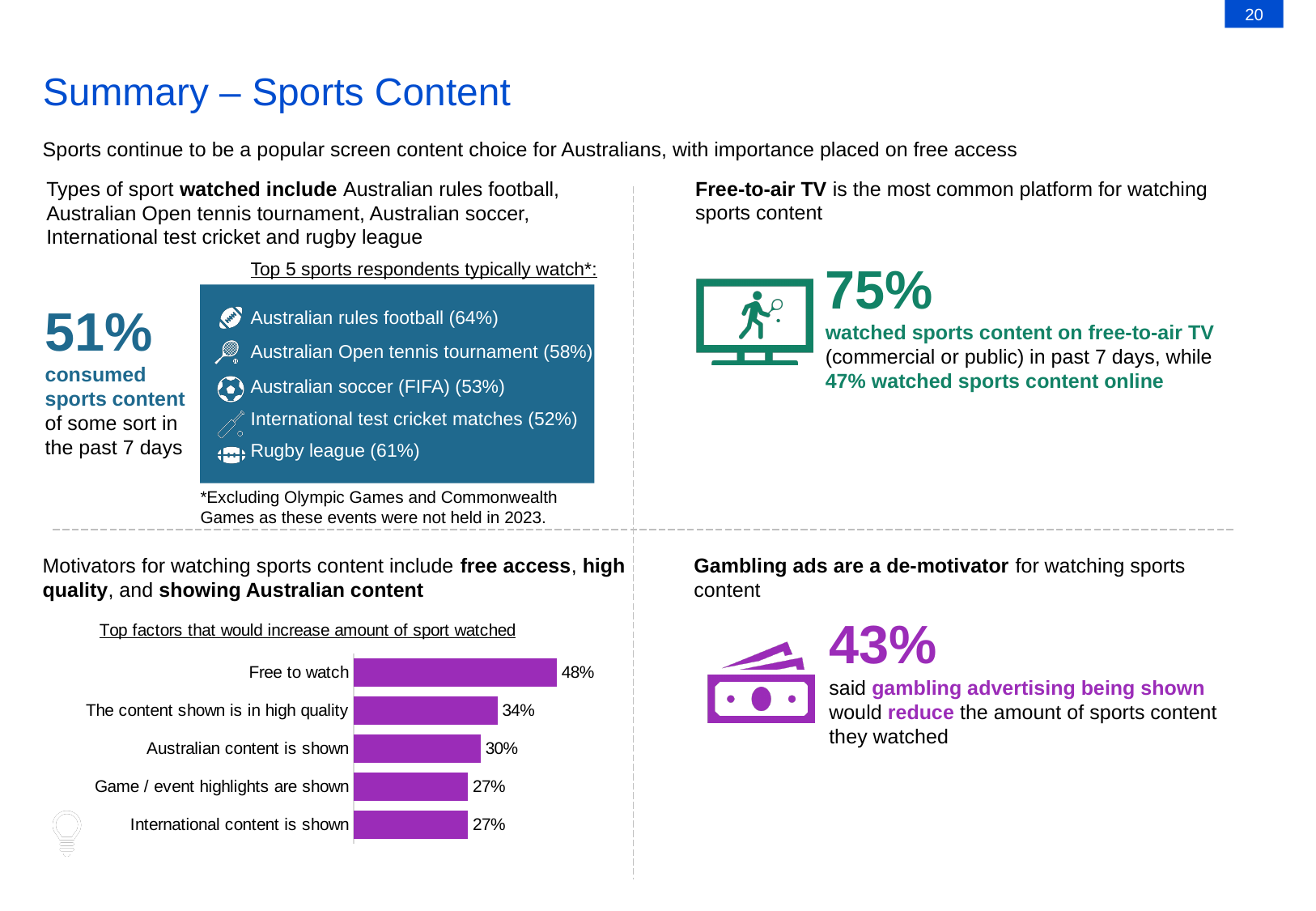
In the "Top factors that would increase amount of sport watched" chart, what is the difference between "Free to watch" and "The content shown is in high quality"? 14% In the "Top factors that would increase amount of sport watched" chart, what is the difference between "Australian content is shown" and "International content is shown"? 3% In the "Top factors that would increase amount of sport watched" chart, which two factors share the same value? Game / event highlights are shown and International content is shown What kind of chart is "Top factors that would increase amount of sport watched"? bar chart In the "Top factors that would increase amount of sport watched" chart, what is the value for "The content shown is in high quality"? 34% In the "Top factors that would increase amount of sport watched" chart, what is the value for "Australian content is shown"? 30% In the "Top factors that would increase amount of sport watched" chart, which is larger: "The content shown is in high quality" or "Australian content is shown"? The content shown is in high quality In the "Top factors that would increase amount of sport watched" chart, what is the value for "Game / event highlights are shown"? 27% What colour are the bars in the "Top factors that would increase amount of sport watched" chart? purple In the "Top factors that would increase amount of sport watched" chart, which factor has the highest value? Free to watch In the "Top factors that would increase amount of sport watched" chart, what is the value for "Free to watch"? 48% In the "Top factors that would increase amount of sport watched" chart, how many factors are shown? 5